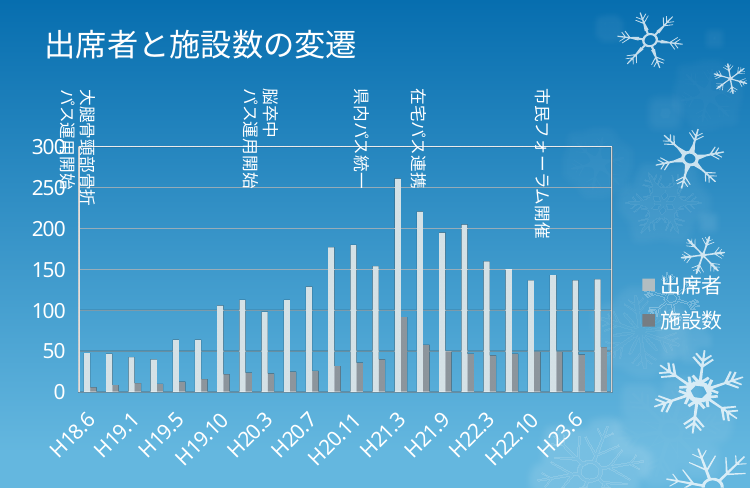
Is the 出席者 value at H18.6 greater or less than 100? less What kind of chart is shown on the slide? bar chart Which is larger, the 施設数 value at H18.6 or at H23.6? H23.6 Which is larger, the 出席者 value at H21.3 or at H23.6? H21.3 At which x-axis label is the 出席者 value highest? H21.3 Is the 出席者 value at H21.3 greater or less than 200? greater Is the 出席者 value at H20.7 greater or less than 100? greater Does the 施設数 series generally rise or fall from H18.6 to H23.6? rise How many series does the legend list? 2 What is the title of the chart? 出席者と施設数の変遷 Which two series are listed in the legend? 出席者 and 施設数